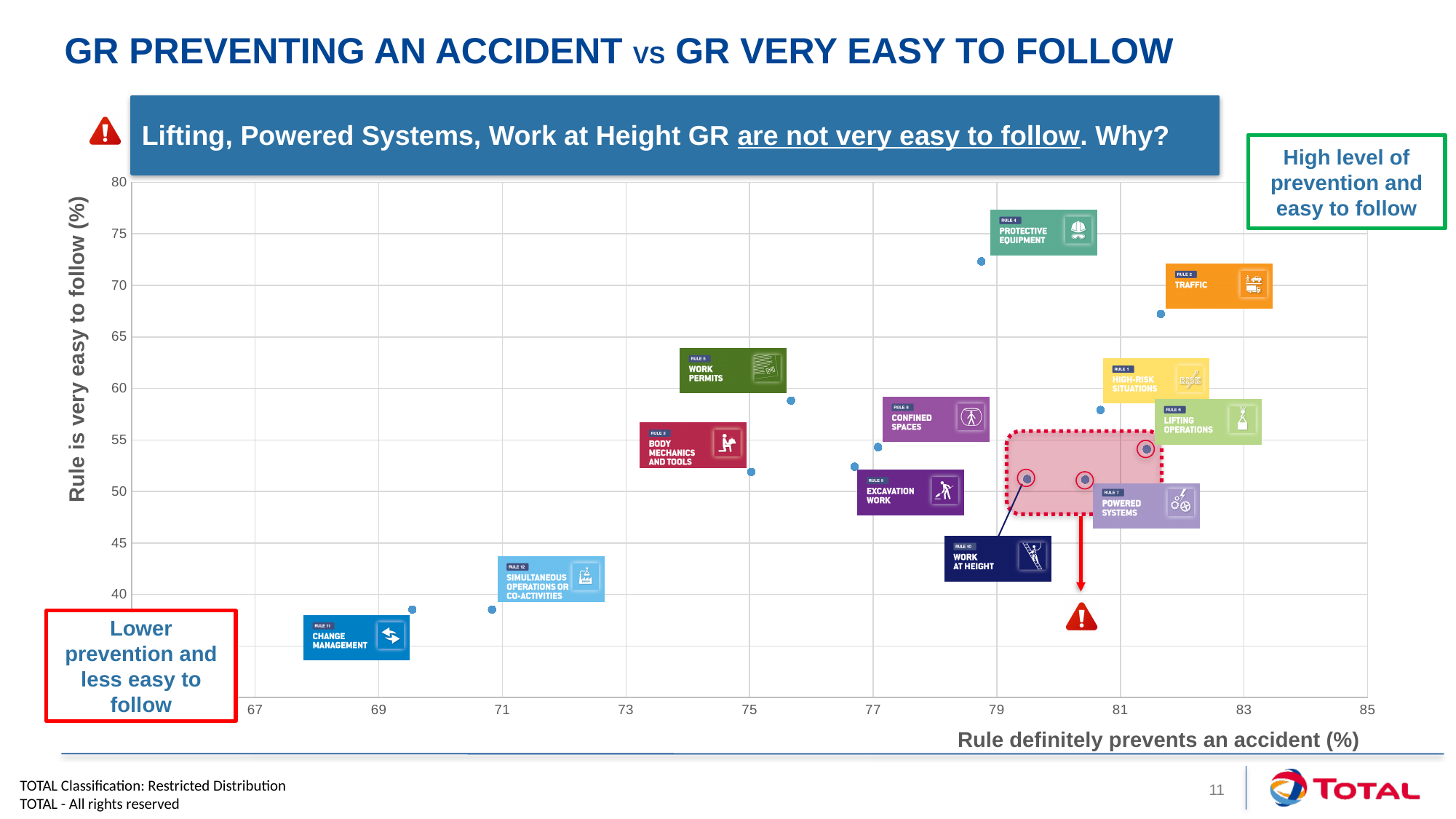
What is the title of the chart's horizontal axis? Rule definitely prevents an accident (%) What kind of chart is shown on the slide? Scatter chart Is the 'Rule is very easy to follow' value for Protective Equipment greater or less than 70? greater What is the title of the chart's vertical axis? Rule is very easy to follow (%) Which rule has a higher 'Rule definitely prevents an accident' value, Change Management or Traffic? Traffic Is the 'Rule is very easy to follow' value for Work Permits greater or less than 55? greater Is the 'Rule definitely prevents an accident' value for Traffic greater or less than 80? greater Which rule has the lowest value for 'Rule definitely prevents an accident (%)'? Change Management Which rule has the highest value for 'Rule is very easy to follow (%)'? Protective Equipment How many data points are plotted on the chart? 12 Which rule has a higher 'Rule is very easy to follow' value, Protective Equipment or Traffic? Protective Equipment